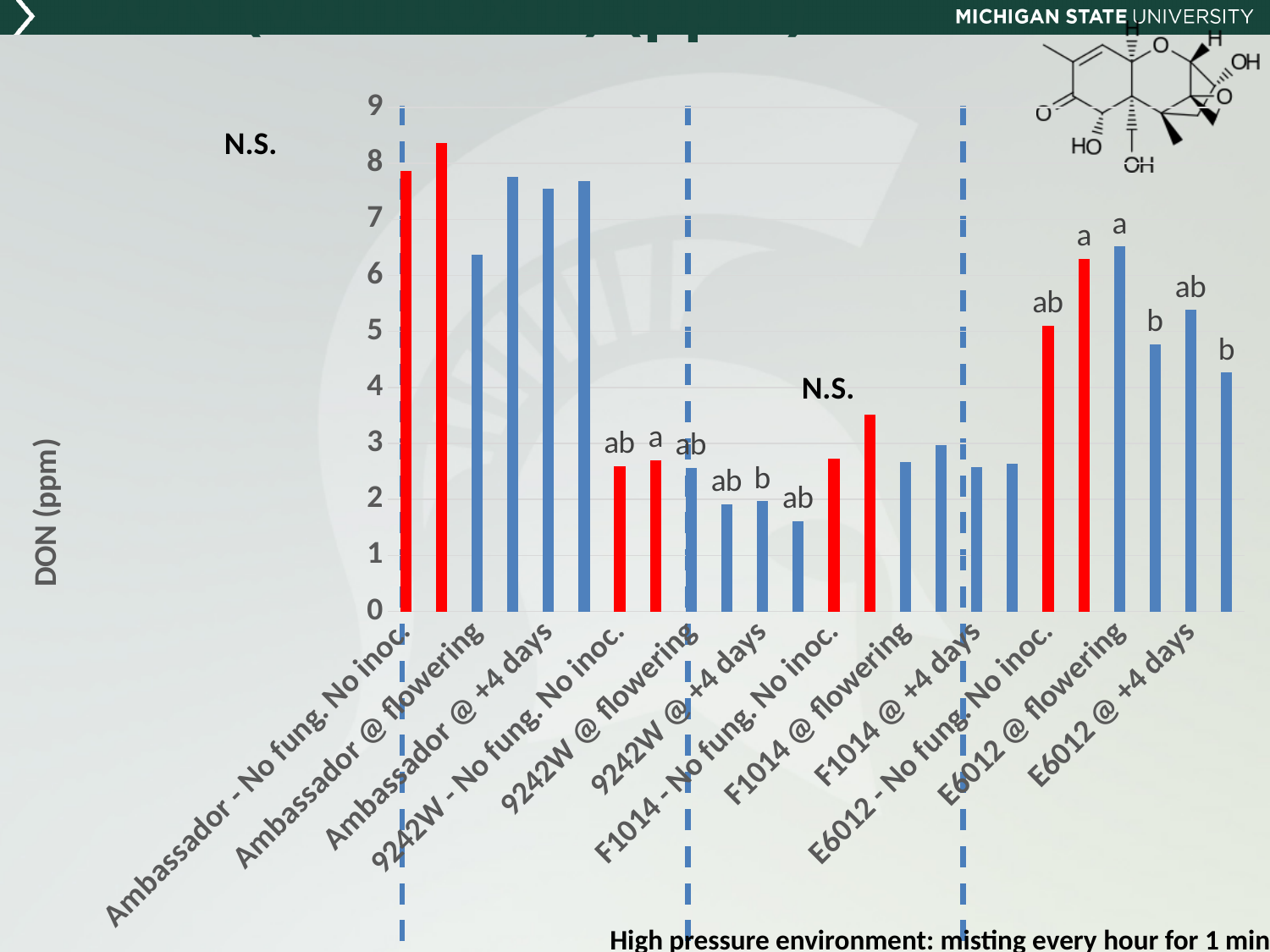
What is the highest value shown on the vertical axis? 9 Which group has higher DON values overall, Ambassador or 9242W? Ambassador How many category labels are shown along the x axis? 12 What kind of chart is shown on the slide? bar chart Is the tallest bar in the Ambassador group greater or less than 8? greater Which group has higher DON values overall, E6012 or F1014? E6012 Is the tallest bar in the F1014 group greater or less than 4? less What is the label of the vertical axis? DON (ppm) Is the tallest bar in the E6012 group greater or less than 6? greater Which variety group contains the shortest bar on the chart? 9242W Which variety group contains the tallest bar on the chart? Ambassador